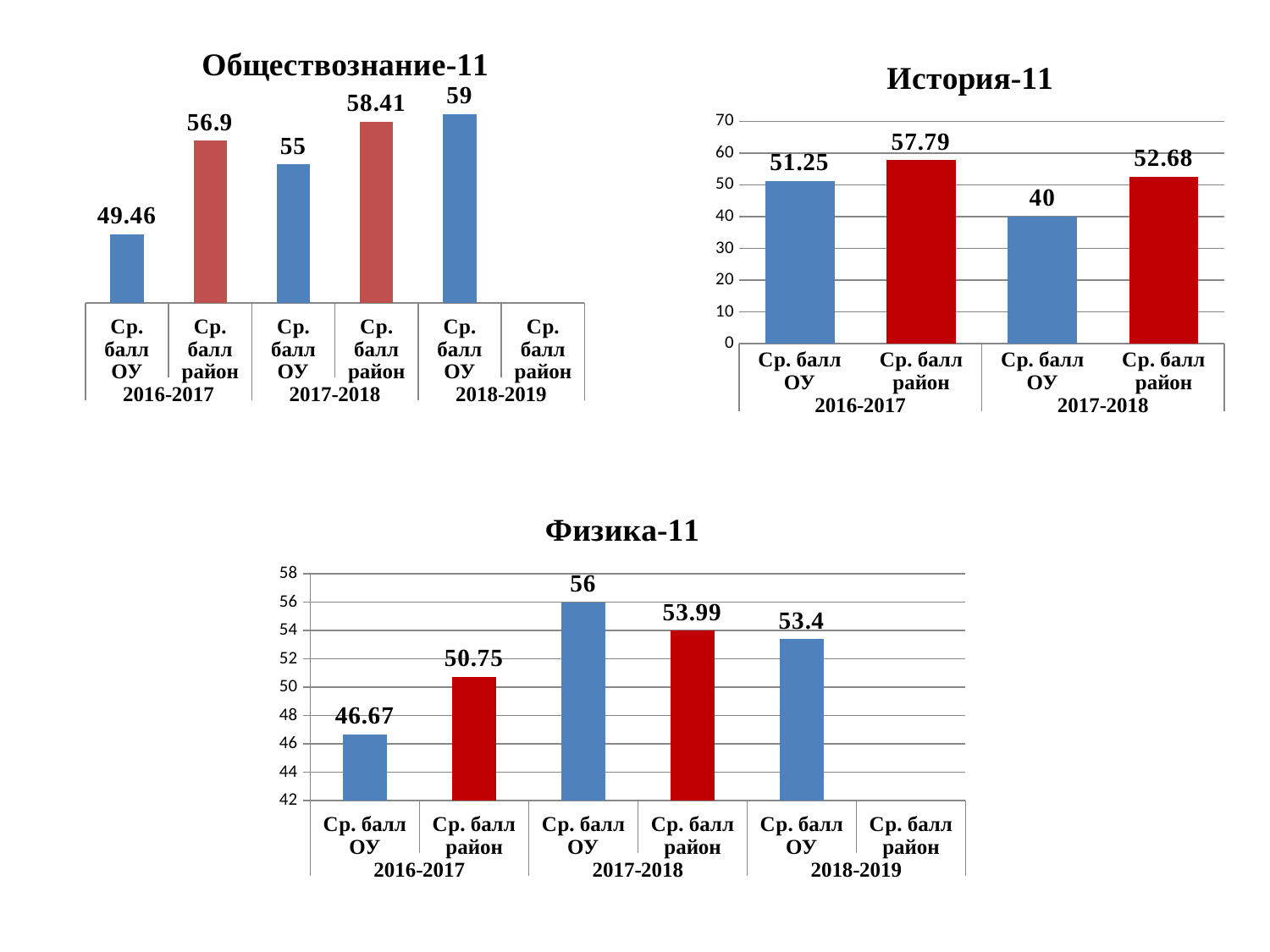
In the "Физика-11" chart, does the value for Ср. балл ОУ rise or fall from 2016-2017 to 2017-2018? rise In the "Обществознание-11" chart, what is the difference between Ср. балл район and Ср. балл ОУ in 2017-2018? 3.41 In the "Обществознание-11" chart, what is the value for Ср. балл ОУ in 2016-2017? 49.46 In the "Обществознание-11" chart, which bar has the highest value? Ср. балл ОУ 2018-2019 In the "История-11" chart, what is the value for Ср. балл ОУ in 2017-2018? 40 What type of chart is "История-11"? bar chart In the "Физика-11" chart, what is the value for Ср. балл район in 2016-2017? 50.75 In the "История-11" chart, which bar has the lowest value? Ср. балл ОУ 2017-2018 In the "Физика-11" chart, which bar has the highest value? Ср. балл ОУ 2017-2018 In the "История-11" chart, what is the difference between Ср. балл район and Ср. балл ОУ in 2016-2017? 6.54 In the "История-11" chart, which is larger: Ср. балл район in 2016-2017 or Ср. балл район in 2017-2018? Ср. балл район in 2016-2017 In the "Физика-11" chart, how many bars are plotted? 5